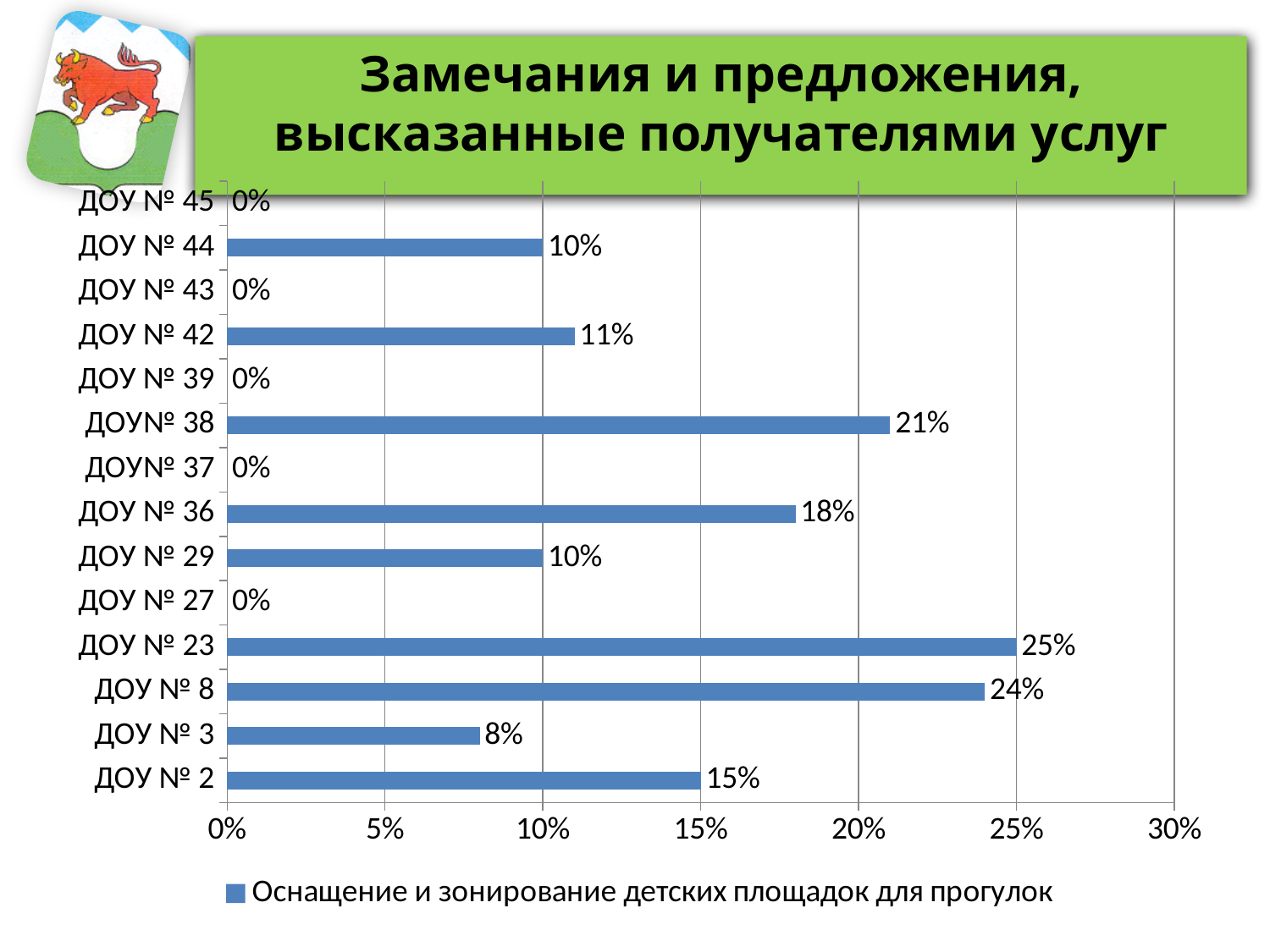
How many series does the legend list? 1 How many categories have a value of 0%? 5 What is the value for ДОУ № 23? 25% What is the legend entry of the series shown? Оснащение и зонирование детских площадок для прогулок What is the difference between the values for ДОУ № 23 and ДОУ № 8? 1% What kind of chart is shown on the slide? Bar chart What is the value for ДОУ № 36? 18% What is the value for ДОУ № 3? 8% Which category has the highest value? ДОУ № 23 What is the difference between the values for ДОУ№ 38 and ДОУ № 2? 6% How many categories are shown on the chart? 14 Which is larger, the value for ДОУ № 42 or the value for ДОУ № 2? ДОУ № 2